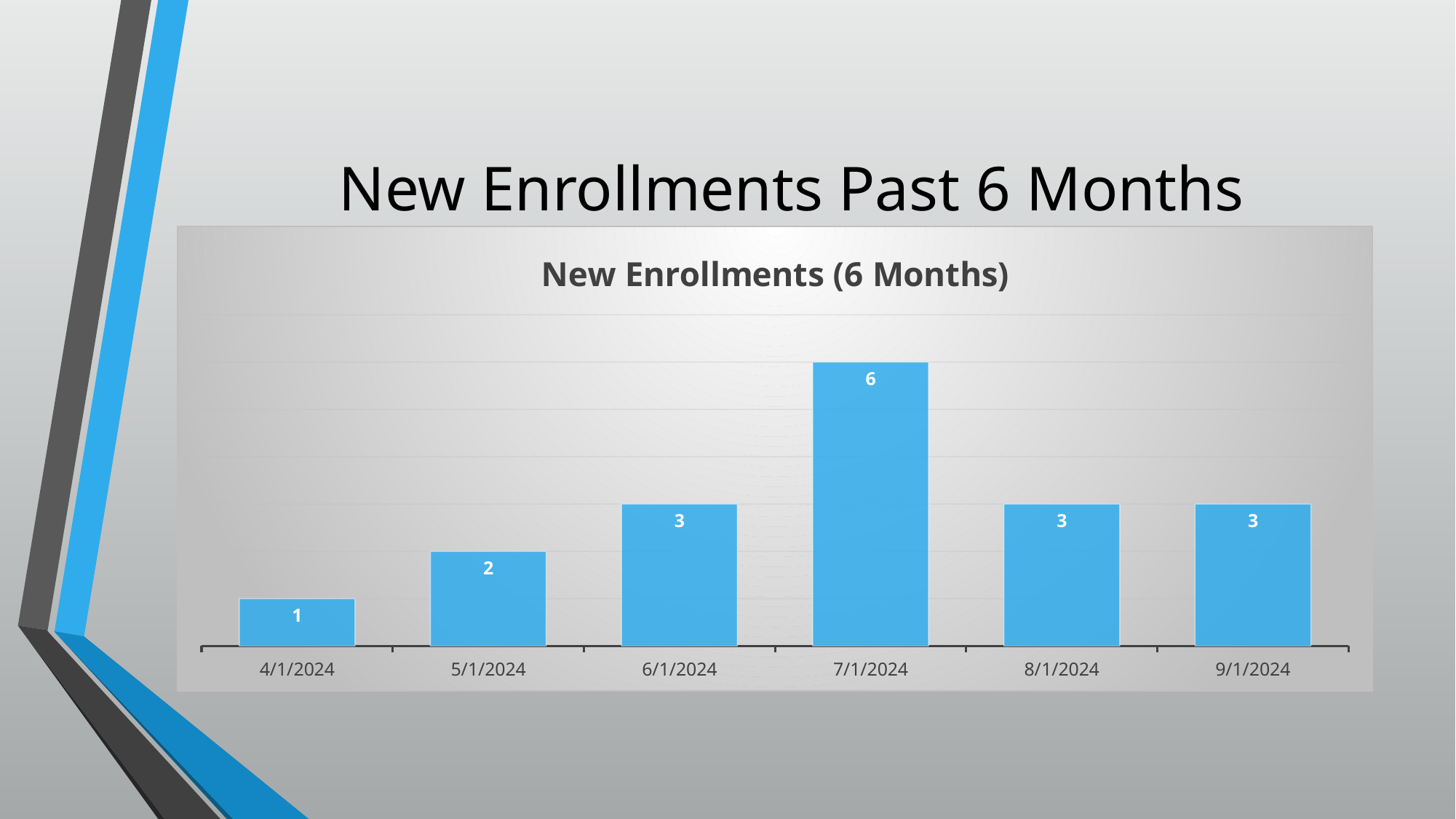
How many months are shown on the x axis? 6 What is the title of the chart? New Enrollments (6 Months) Which month has the highest number of new enrollments? 7/1/2024 Which is larger, the value for 5/1/2024 or the value for 8/1/2024? 8/1/2024 Which month has the lowest number of new enrollments? 4/1/2024 What is the value for 5/1/2024? 2 Do the values rise or fall from 4/1/2024 to 7/1/2024? Rise What is the difference between the values for 7/1/2024 and 6/1/2024? 3 What is the value for 9/1/2024? 3 What kind of chart is shown on the slide? Bar chart What is the value for 4/1/2024? 1 What is the value for 7/1/2024? 6